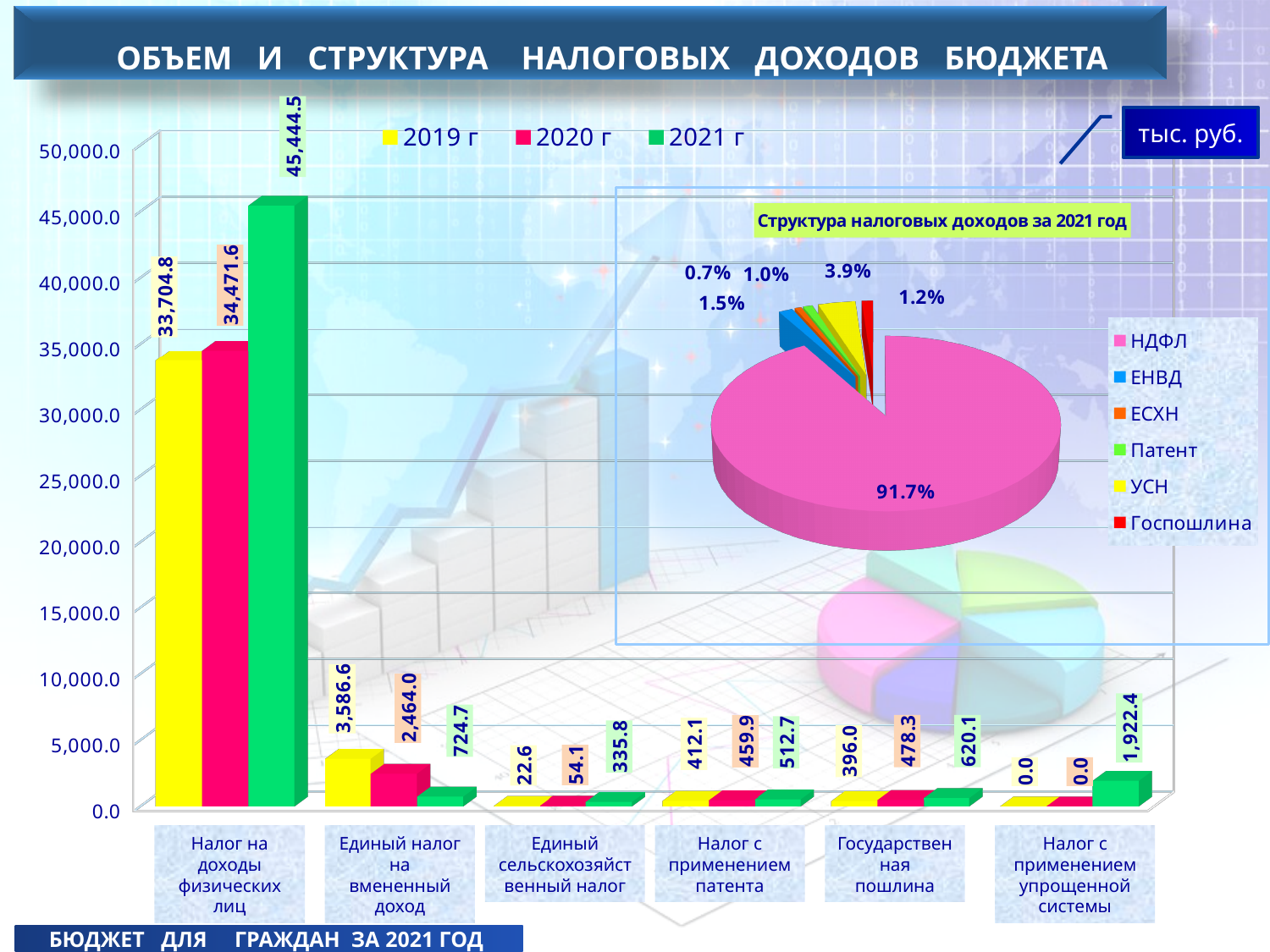
On the bar chart, which is larger for Единый сельскохозяйственный налог: the 2019 г value or the 2021 г value? 2021 г On the bar chart, which category has the lowest 2019 г value? Налог с применением упрощенной системы On the pie chart Структура налоговых доходов за 2021 год, what share does УСН have? 3.9% On the bar chart, how many series does the legend list? 3 On the bar chart, what is the 2021 г value for Налог на доходы физических лиц? 45,444.5 On the bar chart, how many categories are shown on the x axis? 6 On the pie chart Структура налоговых доходов за 2021 год, what share does НДФЛ have? 91.7% On the bar chart, what is the 2021 г value for Налог с применением упрощенной системы? 1,922.4 On the bar chart, what is the difference between the 2021 г and 2020 г values for Налог на доходы физических лиц? 10,972.9 On the bar chart, what is the 2020 г value for Государственная пошлина? 478.3 On the bar chart, which category has the highest 2021 г value? Налог на доходы физических лиц On the bar chart, what is the 2019 г value for Единый налог на вмененный доход? 3,586.6